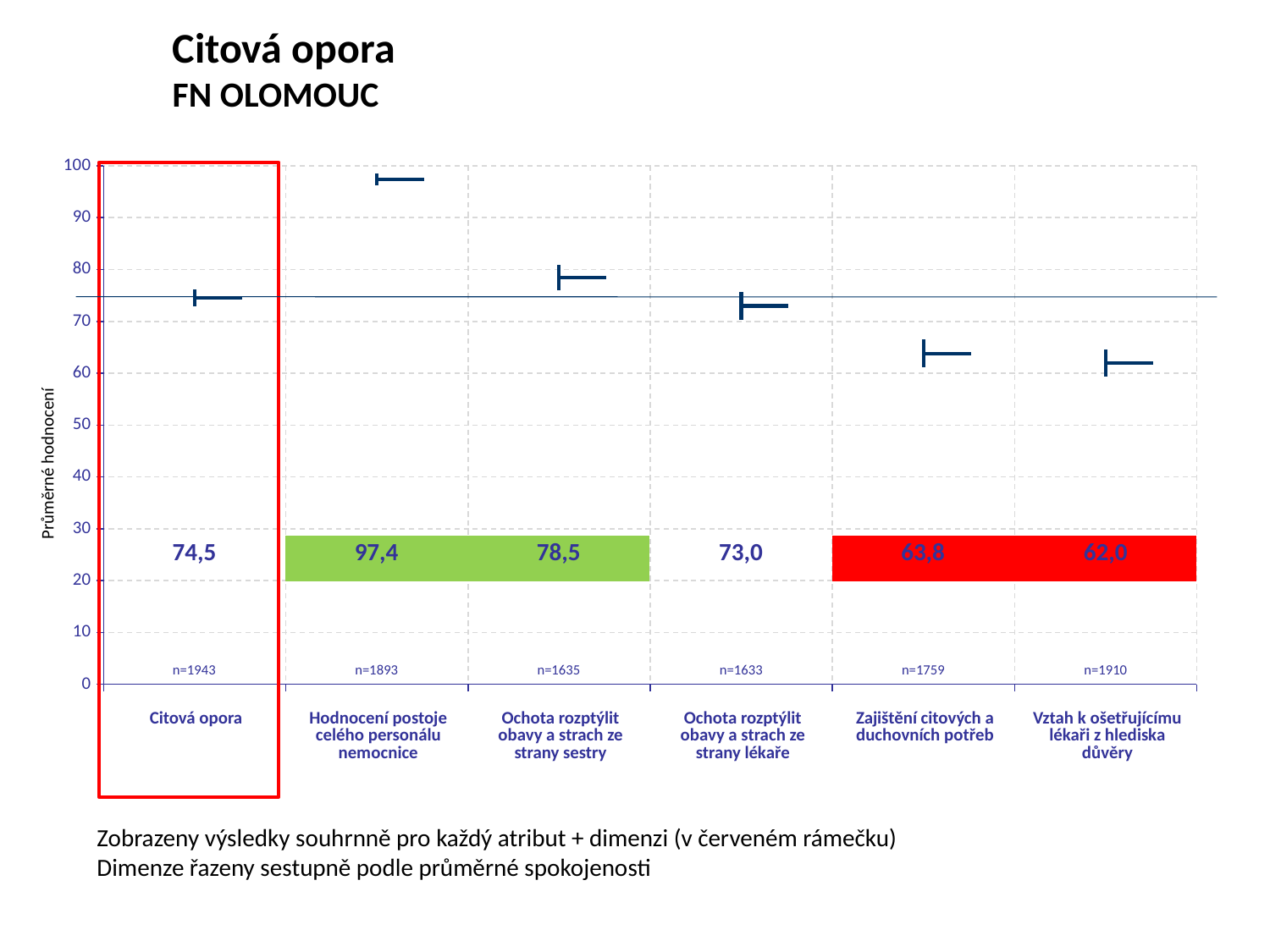
Which is larger, the value for Zajištění citových a duchovních potřeb or the value for Ochota rozptýlit obavy a strach ze strany lékaře? Ochota rozptýlit obavy a strach ze strany lékaře What is the difference between the values for Hodnocení postoje celého personálu nemocnice and Ochota rozptýlit obavy a strach ze strany sestry? 18,9 What is the value for Vztah k ošetřujícímu lékaři z hlediska důvěry? 62,0 What is the value for Ochota rozptýlit obavy a strach ze strany lékaře? 73,0 What is the value for Citová opora? 74,5 Which category has the highest value? Hodnocení postoje celého personálu nemocnice What is the value for Hodnocení postoje celého personálu nemocnice? 97,4 Is the value for Ochota rozptýlit obavy a strach ze strany sestry greater or less than 70? greater What is the label of the y axis? Průměrné hodnocení Which category has the lowest value? Vztah k ošetřujícímu lékaři z hlediska důvěry How many categories are shown on the x axis? 6 What is the sample size (n) shown for Citová opora? n=1943